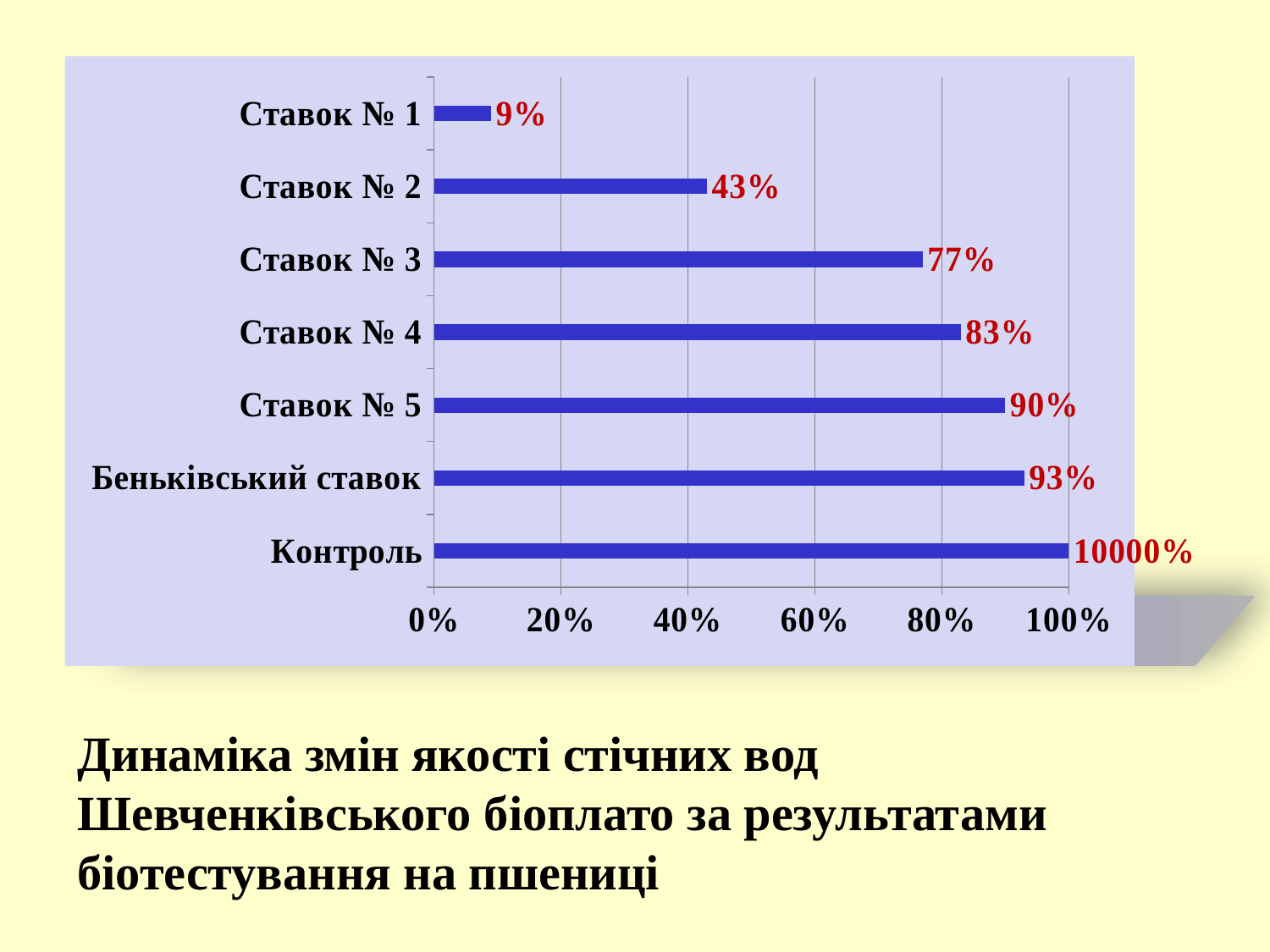
What is the value for Ставок № 5? 90% Which category has the longest bar? Контроль What is the difference between the values for Беньківський ставок and Ставок № 5? 3% Which category has the lowest value? Ставок № 1 What is the difference between the values for Ставок № 4 and Ставок № 2? 40% What is the value for Ставок № 3? 77% How many categories are shown in the chart? 7 What is the value for Беньківський ставок? 93% Which is larger, the value for Ставок № 3 or the value for Ставок № 4? Ставок № 4 What is the value for Ставок № 1? 9% Is the value for Ставок № 2 greater or less than 60%? less What kind of chart is shown on the slide? bar chart